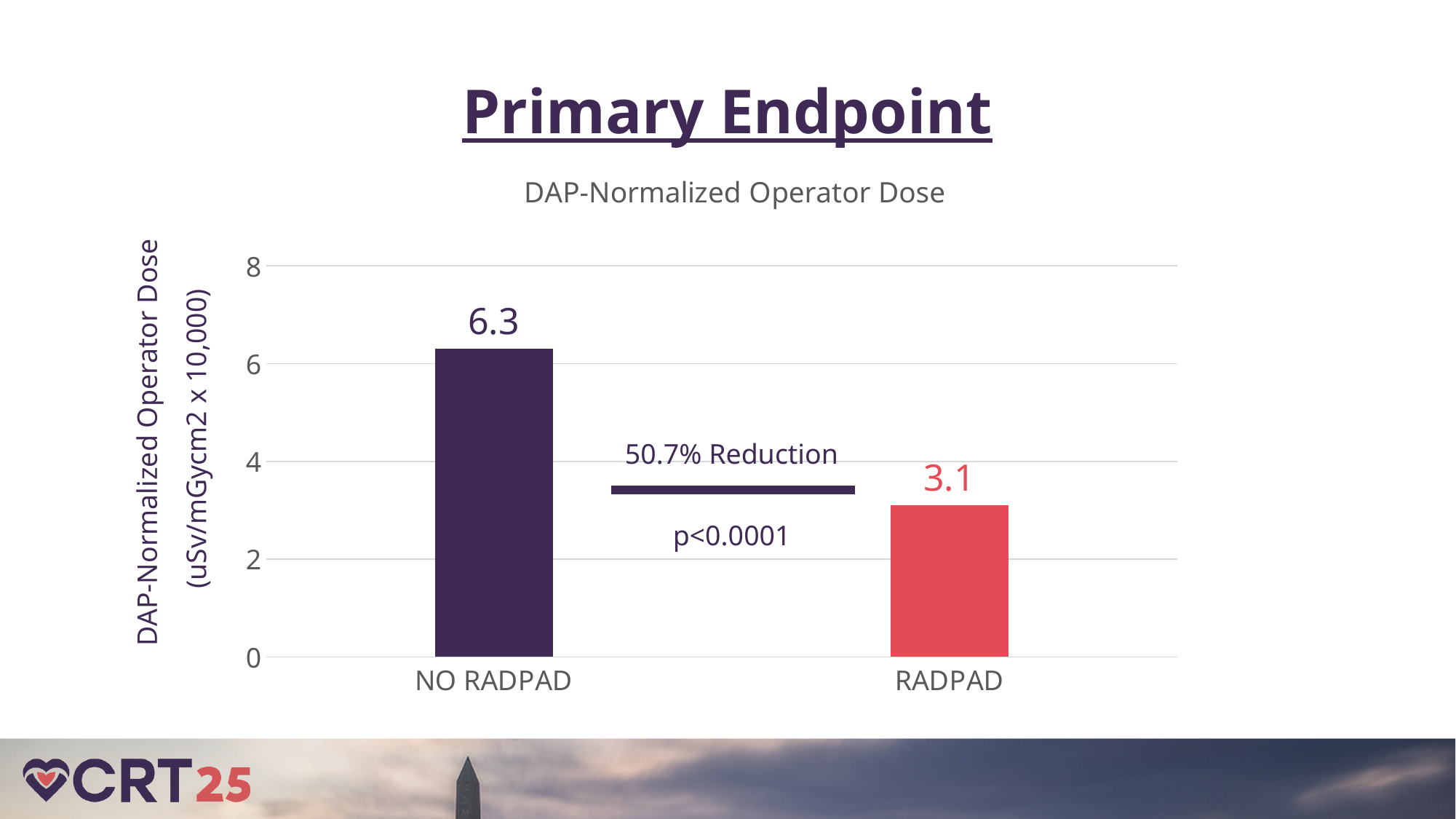
What is the DAP-normalized operator dose for NO RADPAD? 6.3 Is the value for NO RADPAD larger or smaller than the value for RADPAD? larger What kind of chart is shown on the slide? bar chart What is the difference between the NO RADPAD and RADPAD values? 3.2 Which category has the higher DAP-normalized operator dose? NO RADPAD What is the DAP-normalized operator dose for RADPAD? 3.1 Is the value for RADPAD greater or less than 4? less What percentage reduction is annotated between the two bars? 50.7% Which category has the lower DAP-normalized operator dose? RADPAD How many categories are shown on the x axis? 2 Is the value for NO RADPAD greater or less than 6? greater What is the title of the chart? DAP-Normalized Operator Dose